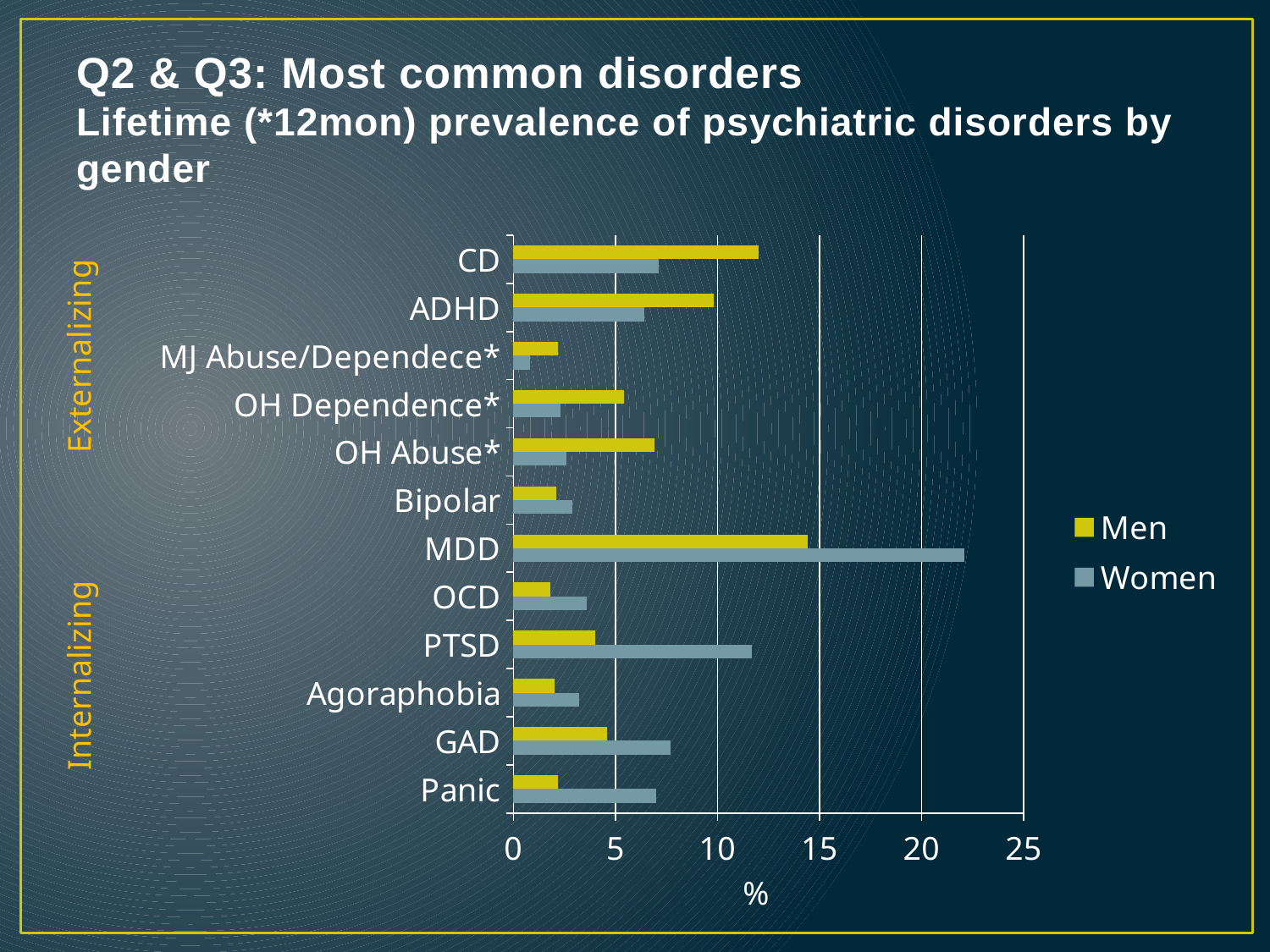
Is the value for Women for MDD greater or less than 20? greater What kind of chart is shown on the slide? bar chart Which disorder has the lowest value for Women? MJ Abuse/Dependece* For CD, which is larger, the value for Men or the value for Women? Men For Panic, which is larger, the value for Men or the value for Women? Women Is the value for Men for MDD greater or less than 15? less Is the value for Women for PTSD greater or less than 10? greater How many series does the legend list? 2 How many disorders (categories) are plotted on the chart? 12 Which disorder has the highest value for Men? MDD Which disorder has the highest value for Women? MDD